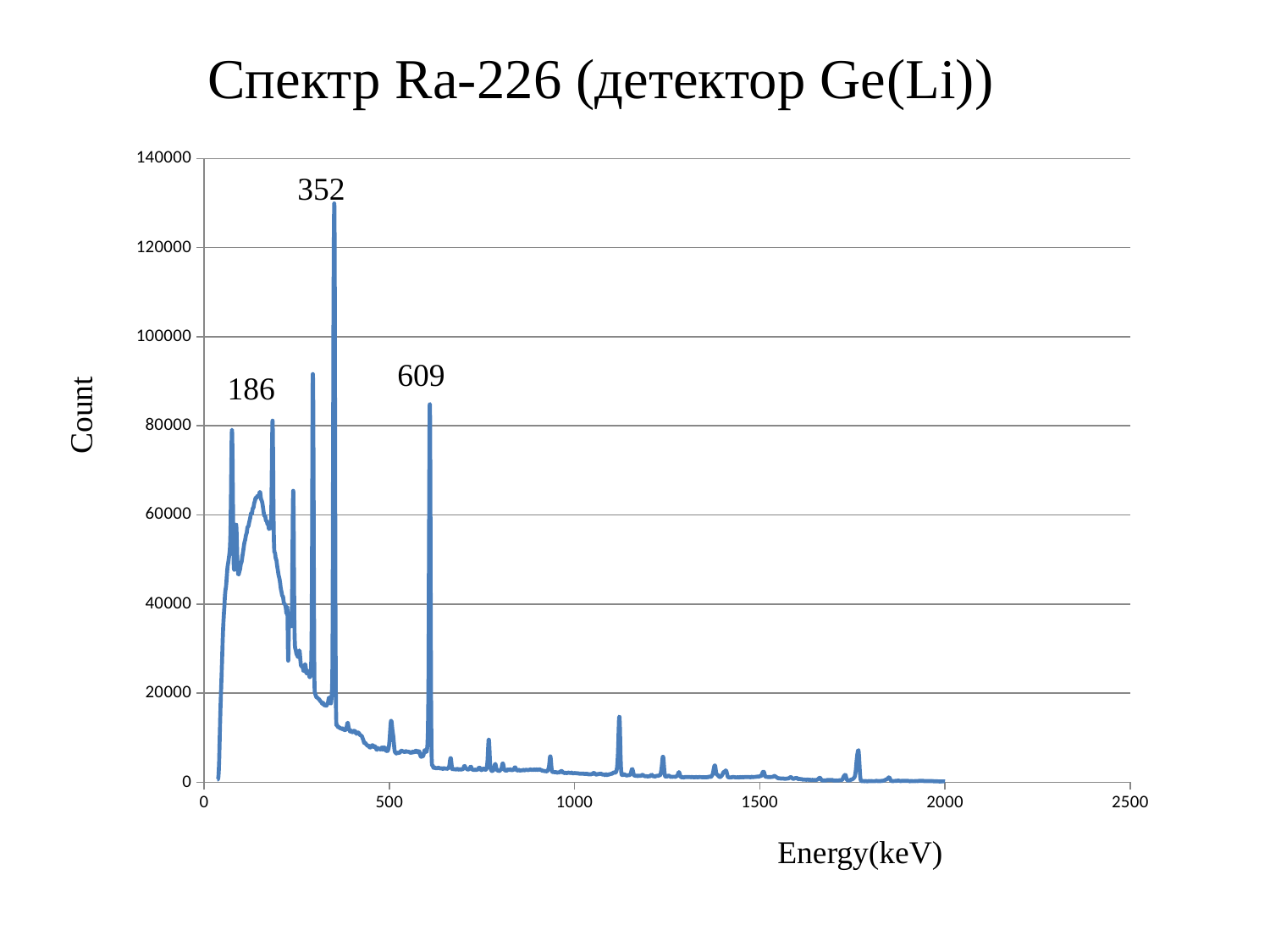
What kind of chart is shown on the slide? line chart Is the count at the peak labeled 352 greater or less than 120000? greater Which labeled peak has the highest count? 352 Is the count at the peak labeled 609 greater or less than 100000? less How many peaks are labeled with an energy value on the chart? 3 Beyond the peak labeled 609, do the counts generally rise or fall as energy increases? fall Which labeled peak has a higher count, 352 or 609? 352 What is the label of the x axis? Energy(keV) What is the title of the chart? Спектр Ra-226 (детектор Ge(Li)) Which labeled peak has the lowest count? 186 Which labeled peak has a higher count, 186 or 352? 352 Is the count at the peak labeled 186 greater or less than 60000? greater